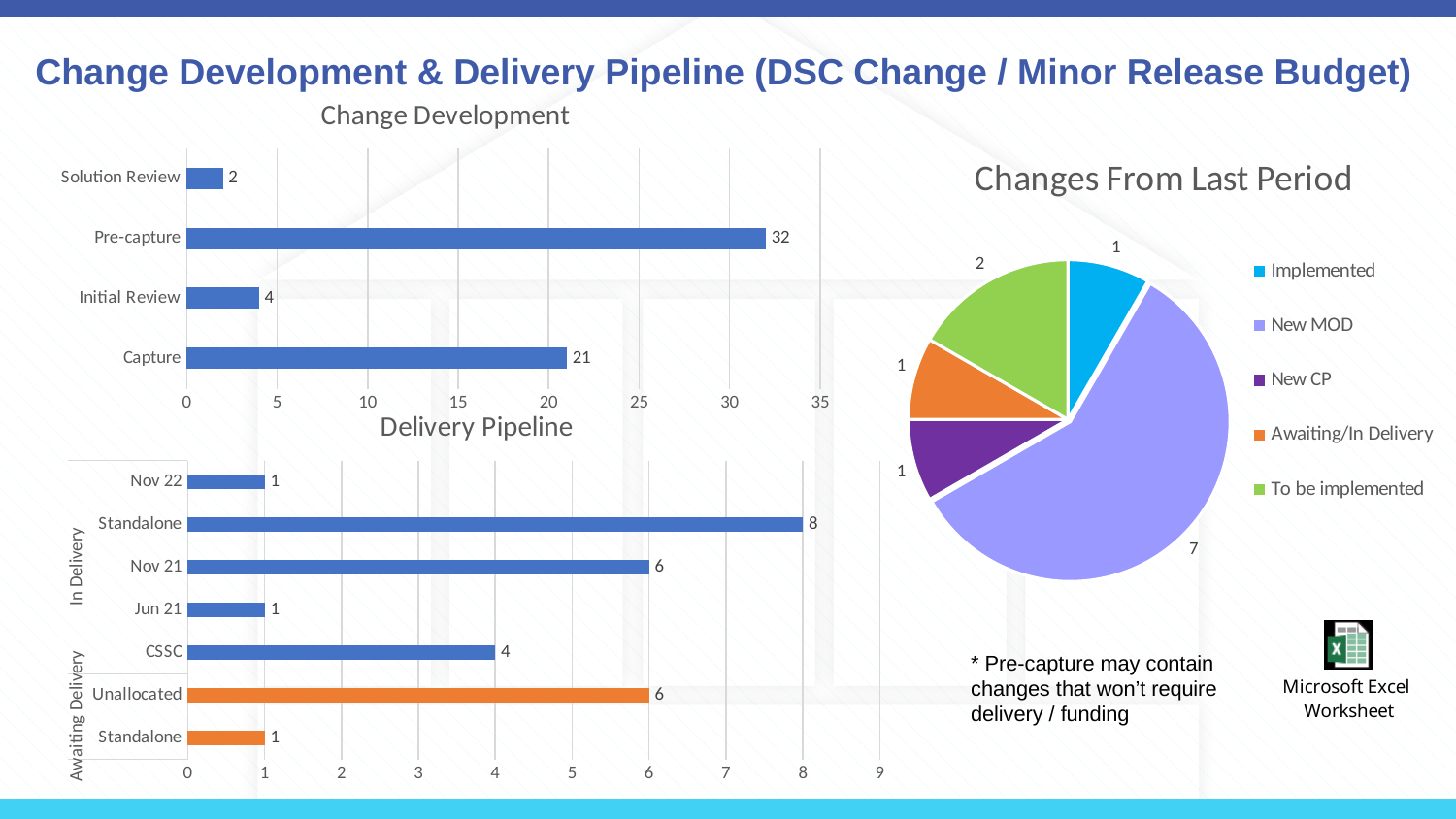
In the Delivery Pipeline chart, which is larger: CSSC or Jun 21? CSSC In the Delivery Pipeline chart, which category has the highest value? Standalone (In Delivery) In the Change Development chart, what is the value for Capture? 21 In the Delivery Pipeline chart, what is the value for Unallocated under Awaiting Delivery? 6 In the Change Development chart, how many categories are shown? 4 In the Change Development chart, what is the difference between Pre-capture and Capture? 11 In the Changes From Last Period chart, what is the value for New MOD? 7 In the Change Development chart, what is the value for Pre-capture? 32 What kind of chart is the Changes From Last Period chart? Pie chart In the Change Development chart, which category has the lowest value? Solution Review In the Delivery Pipeline chart, what is the value for Nov 21 under In Delivery? 6 How many entries does the legend of the Changes From Last Period chart list? 5